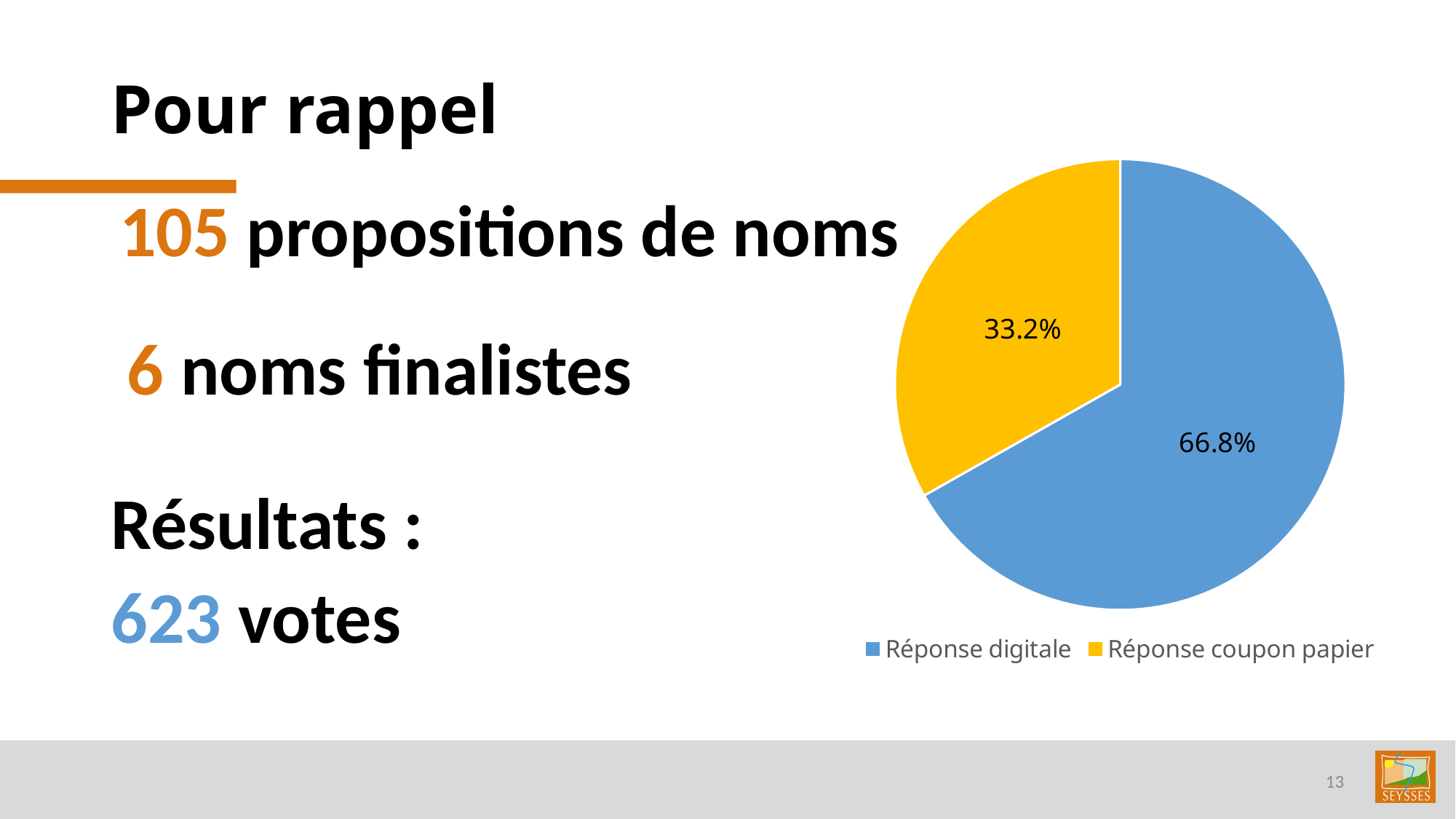
What share of the pie does Réponse coupon papier represent? 33.2% What share of the pie does Réponse digitale represent? 66.8% What colour is the slice for Réponse coupon papier? yellow How many slices does the pie chart have? 2 Which category has the smallest slice of the pie? Réponse coupon papier What colour is the slice for Réponse digitale? blue Which category has the largest slice of the pie? Réponse digitale How many entries does the legend list? 2 What is the difference in percentage points between Réponse digitale and Réponse coupon papier? 33.6 Which is larger, the slice for Réponse digitale or the slice for Réponse coupon papier? Réponse digitale What kind of chart is shown on the slide? pie chart